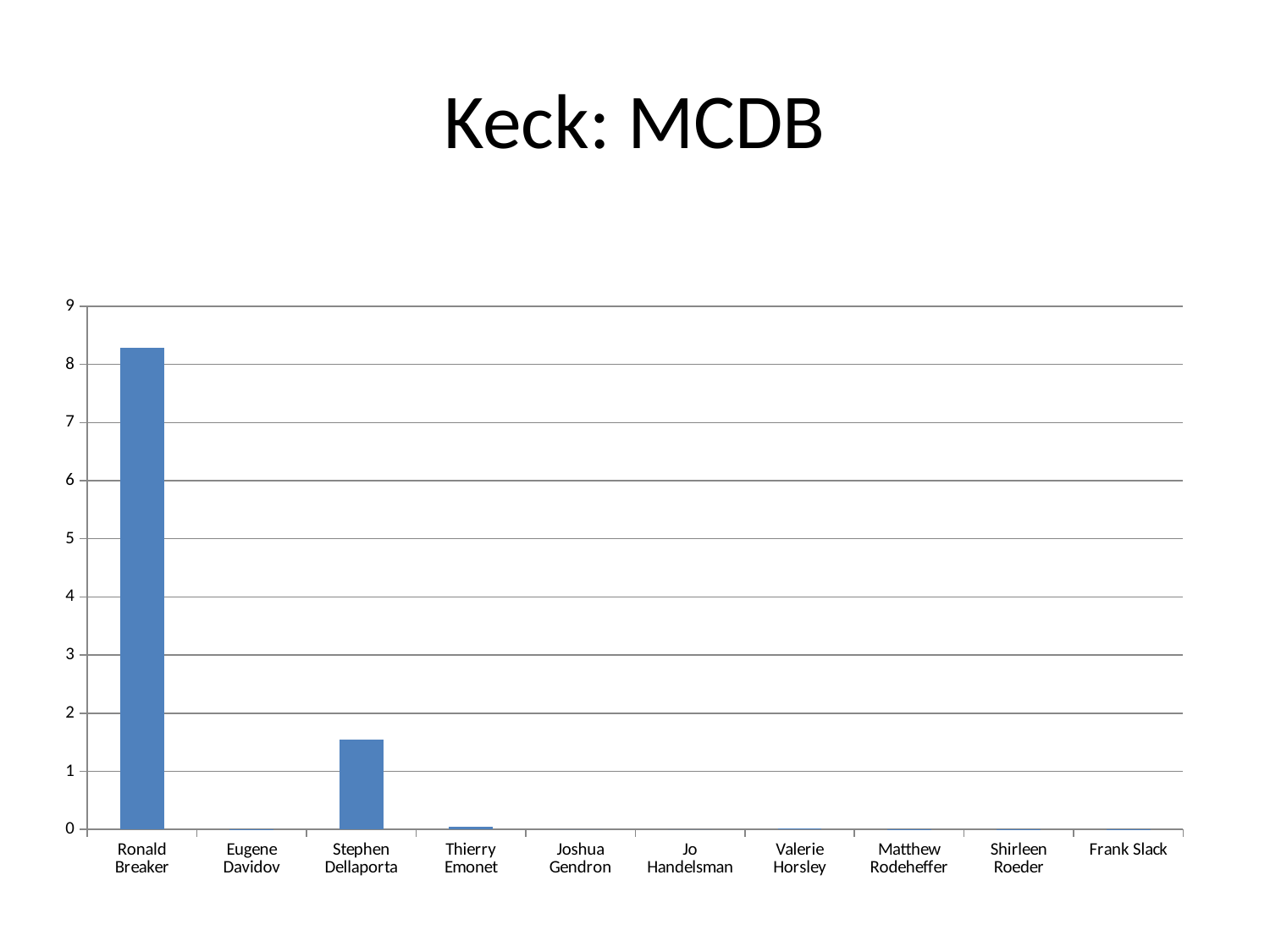
Which category has the highest value? Ronald Breaker What kind of chart is shown on the slide? bar chart Which has the larger value, Ronald Breaker or Stephen Dellaporta? Ronald Breaker Is the value for Stephen Dellaporta greater or less than 2? less Is the value for Thierry Emonet greater or less than 1? less Is the value for Stephen Dellaporta greater or less than 1? greater How many categories (people) are shown along the x axis? 10 Which category has the second-highest value? Stephen Dellaporta What is the title of the chart on the slide? Keck: MCDB Which has the larger value, Stephen Dellaporta or Thierry Emonet? Stephen Dellaporta